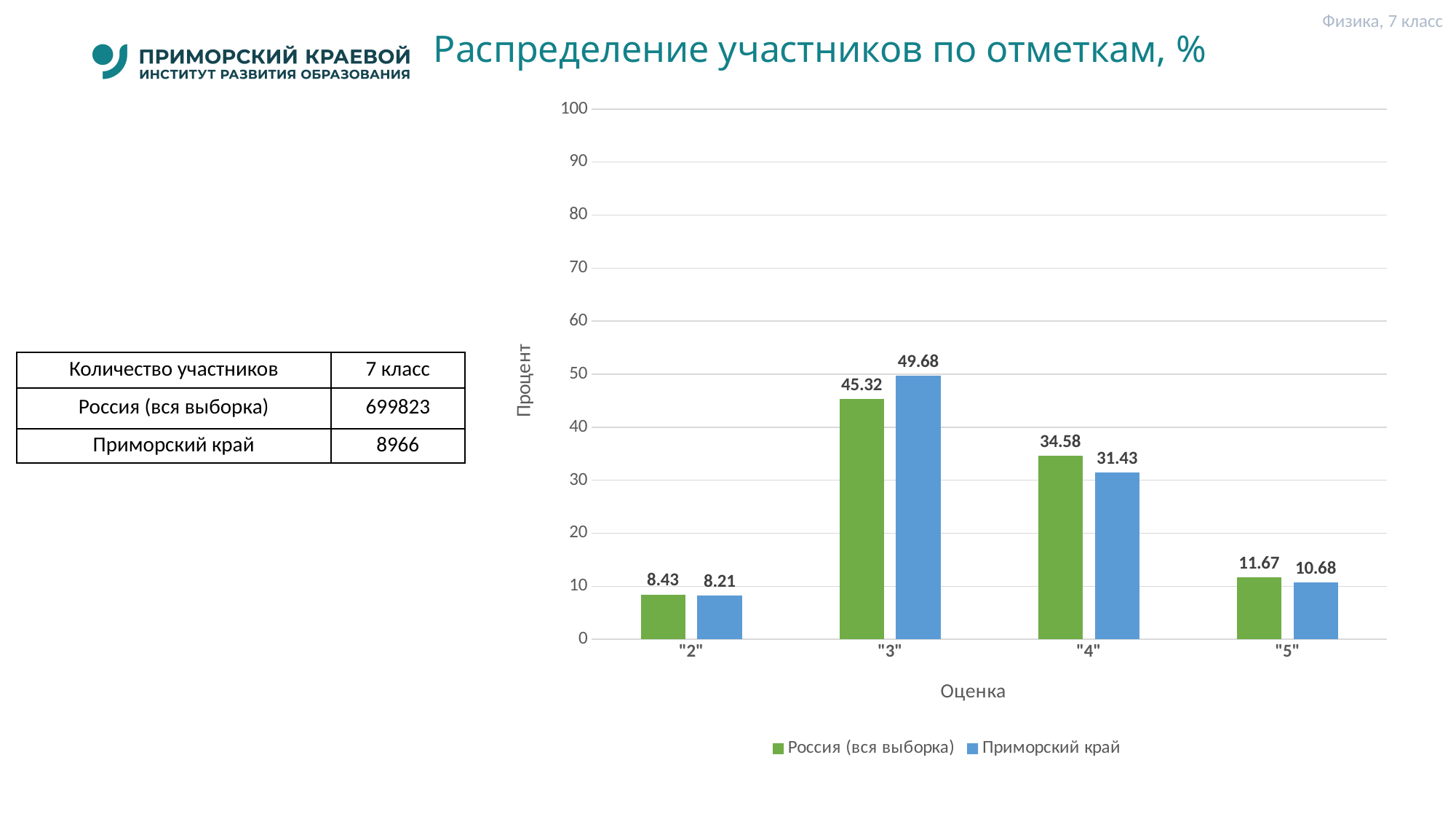
How many grade categories are shown on the x axis? 4 Which grade has the highest value for Россия (вся выборка)? "3" Is the value for Приморский край at grade "4" greater or less than 40? less What is the difference between Россия (вся выборка) and Приморский край at grade "4"? 3.15 What is the label of the x axis? Оценка Which grade has the lowest value for Приморский край? "2" At grade "3", which series has the larger value: Россия (вся выборка) or Приморский край? Приморский край What kind of chart is shown on the slide? bar chart How many series does the legend list? 2 What is the value for Россия (вся выборка) at grade "4"? 34.58 What is the value for Приморский край at grade "5"? 10.68 What is the value for Приморский край at grade "3"? 49.68